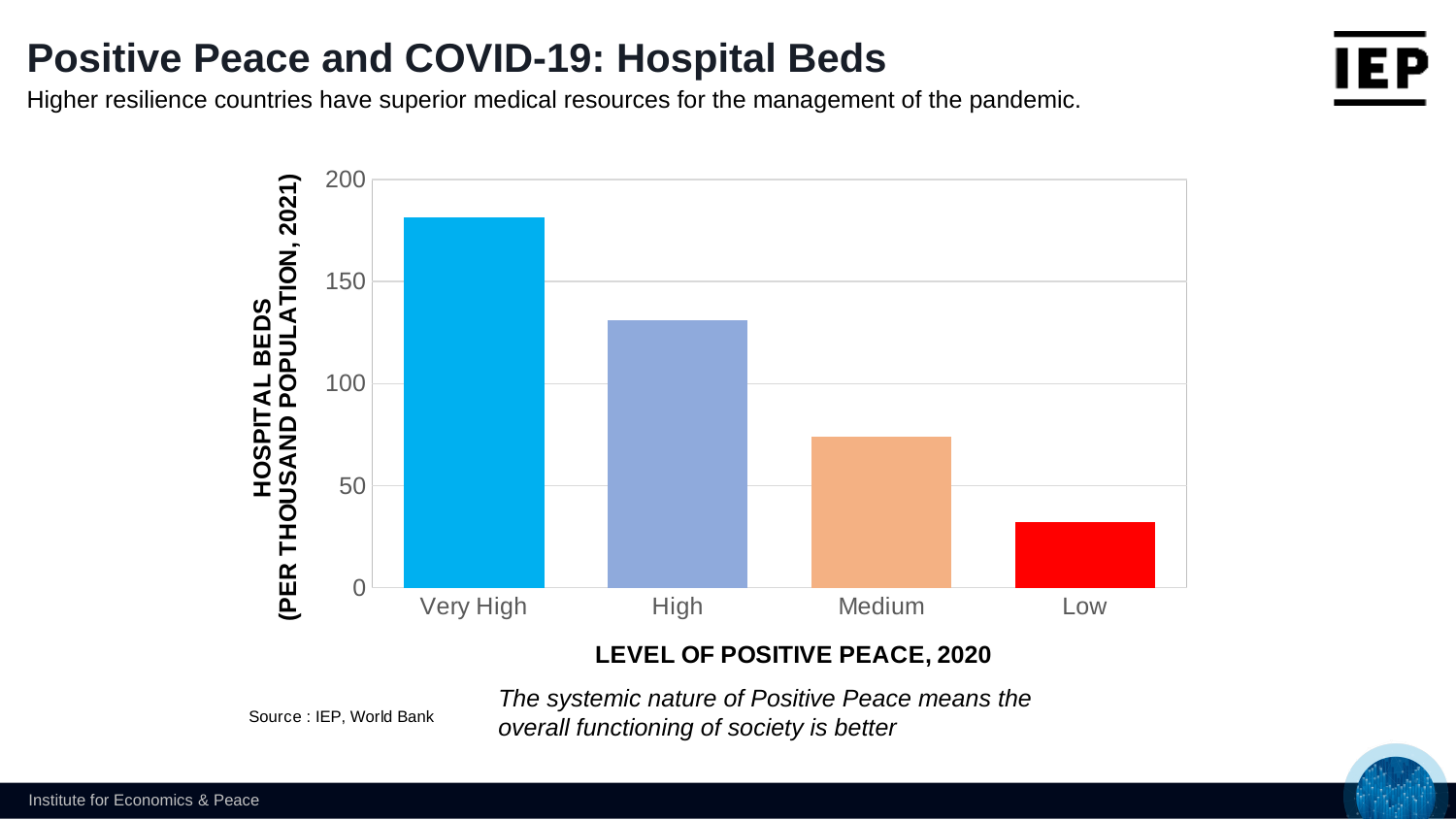
What colour is the bar for the Low level of Positive Peace? red Is the value for Low greater or less than 50? less Which level of Positive Peace has the highest number of hospital beds per thousand population? Very High What kind of chart is shown on the slide? bar chart Do the values rise or fall moving from Very High to Low along the x axis? fall Is the value for Medium greater or less than 50? greater How many levels of Positive Peace are shown on the x axis of the chart? 4 Which level of Positive Peace has the lowest number of hospital beds per thousand population? Low Is the value for Very High greater or less than 150? greater What is the label of the x axis of the chart? LEVEL OF POSITIVE PEACE, 2020 Which has more hospital beds per thousand population, High or Medium? High